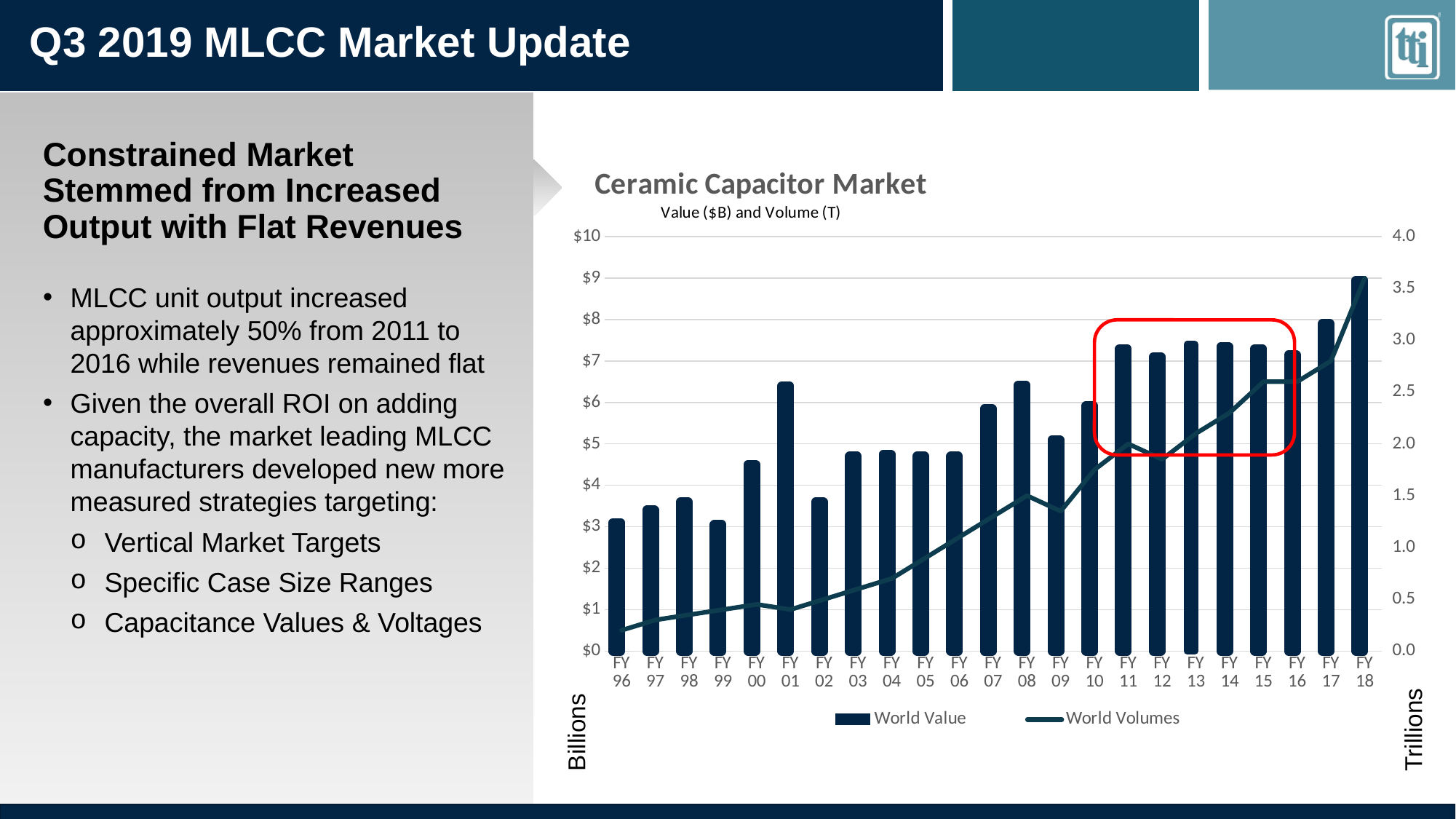
Is the World Value for FY 01 greater or less than $6? greater What is the title of the chart on the slide? Ceramic Capacitor Market Does the World Volumes line generally rise or fall from FY 96 to FY 18? rise What are the two series named in the chart's legend? World Value and World Volumes Is the World Value for FY 02 greater or less than $4? less How many fiscal years are shown along the x axis of the chart? 23 Which fiscal year has the highest World Value bar? FY 18 Which has the larger World Value bar, FY 07 or FY 08? FY 08 Is the World Value for FY 09 greater or less than $6? less How many series does the chart's legend list? 2 What kind of chart is shown on the slide? A bar chart combined with a line chart